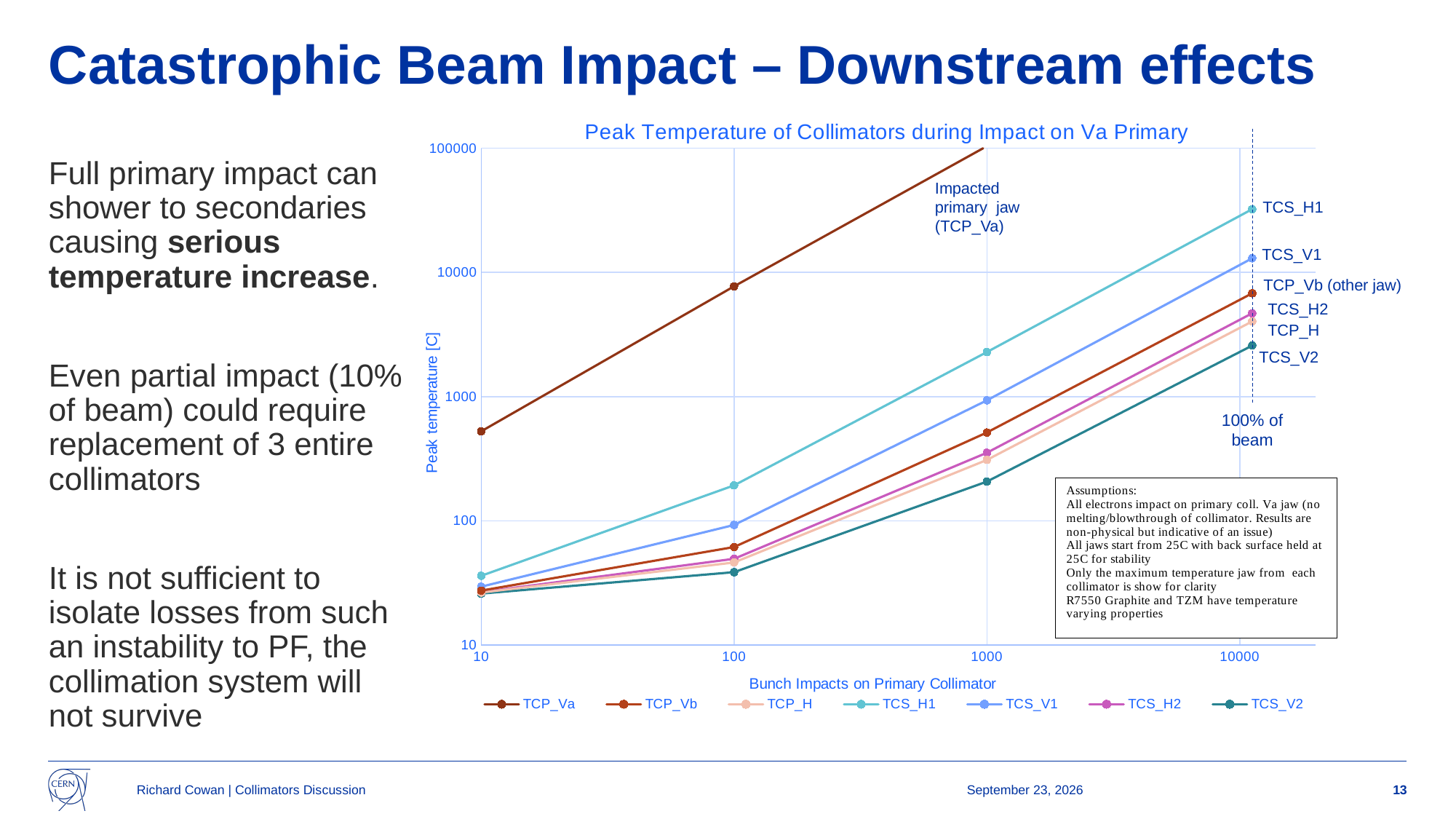
What kind of chart is shown on the slide? line chart Is the peak temperature for TCS_H1 at 10000 bunch impacts greater or less than 10000? greater At 1000 bunch impacts, which has the higher peak temperature, TCS_H1 or TCS_V1? TCS_H1 What is the title of the chart? Peak Temperature of Collimators during Impact on Va Primary Which series has the lowest peak temperature at 10000 bunch impacts? TCS_V2 Do the peak temperatures rise or fall as the number of bunch impacts increases? rise What is the label of the x axis? Bunch Impacts on Primary Collimator Is the peak temperature for TCP_Va at 100 bunch impacts greater or less than 1000? greater Is the peak temperature for TCS_V2 at 1000 bunch impacts greater or less than 1000? less How many series does the legend list? 7 Which series has the highest peak temperature at 10 bunch impacts? TCP_Va